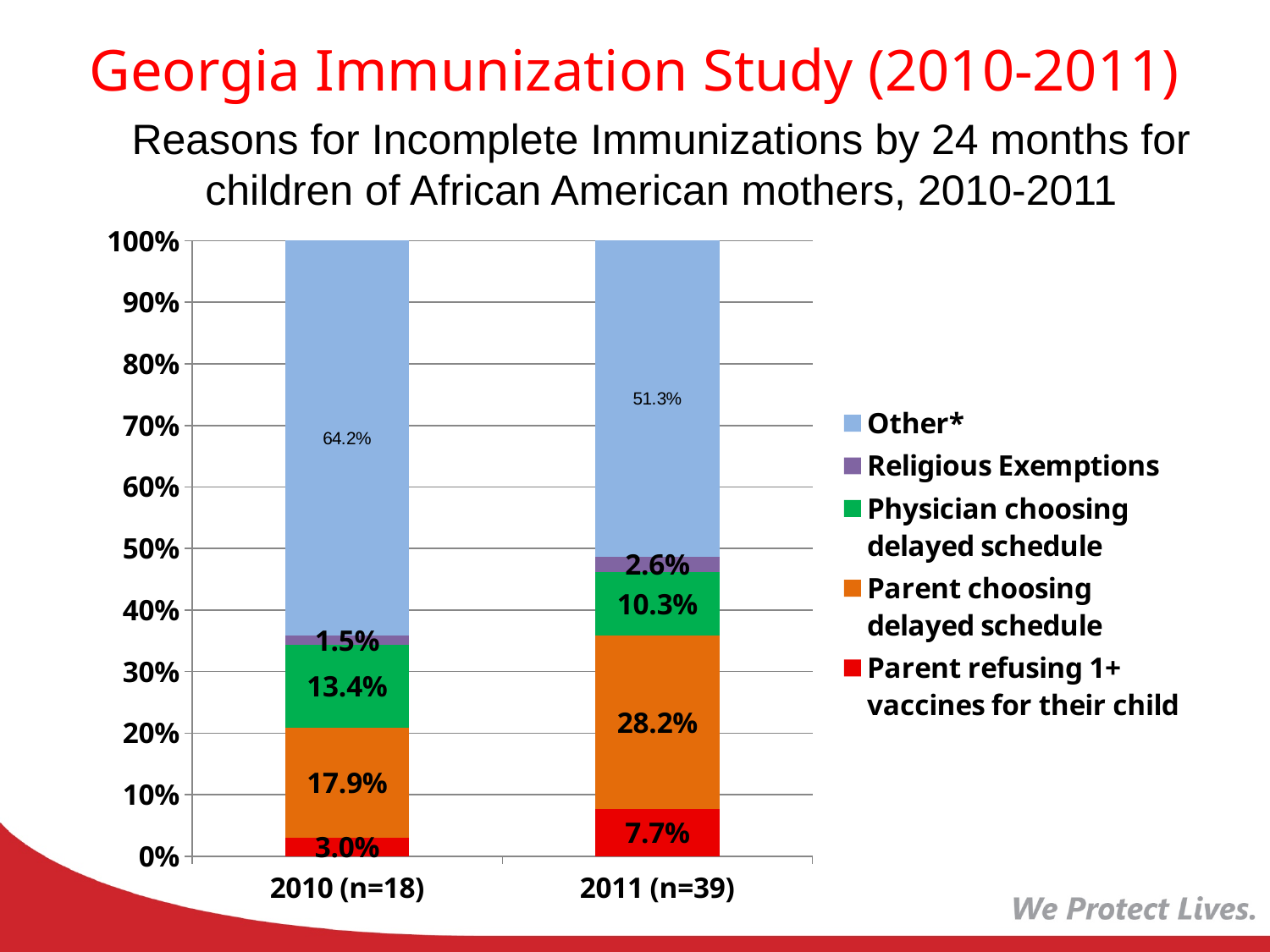
What is the value for Religious Exemptions in 2011 (n=39)? 2.6% How many series does the legend list? 5 Does the Other* share rise or fall from 2010 (n=18) to 2011 (n=39)? Fall Which series has the smallest share in the 2010 (n=18) bar? Religious Exemptions How many bars (categories) are plotted on the x axis? 2 What kind of chart is shown on the slide? Stacked bar chart What is the difference between the Parent choosing delayed schedule values for 2011 (n=39) and 2010 (n=18)? 10.3% What is the value for Other* in 2010 (n=18)? 64.2% What is the value for Parent choosing delayed schedule in 2011 (n=39)? 28.2% Which is larger: Physician choosing delayed schedule in 2010 (n=18) or in 2011 (n=39)? 2010 (n=18) What is the value for Parent refusing 1+ vaccines for their child in 2010 (n=18)? 3.0% Which series has the largest share in the 2011 (n=39) bar? Other*